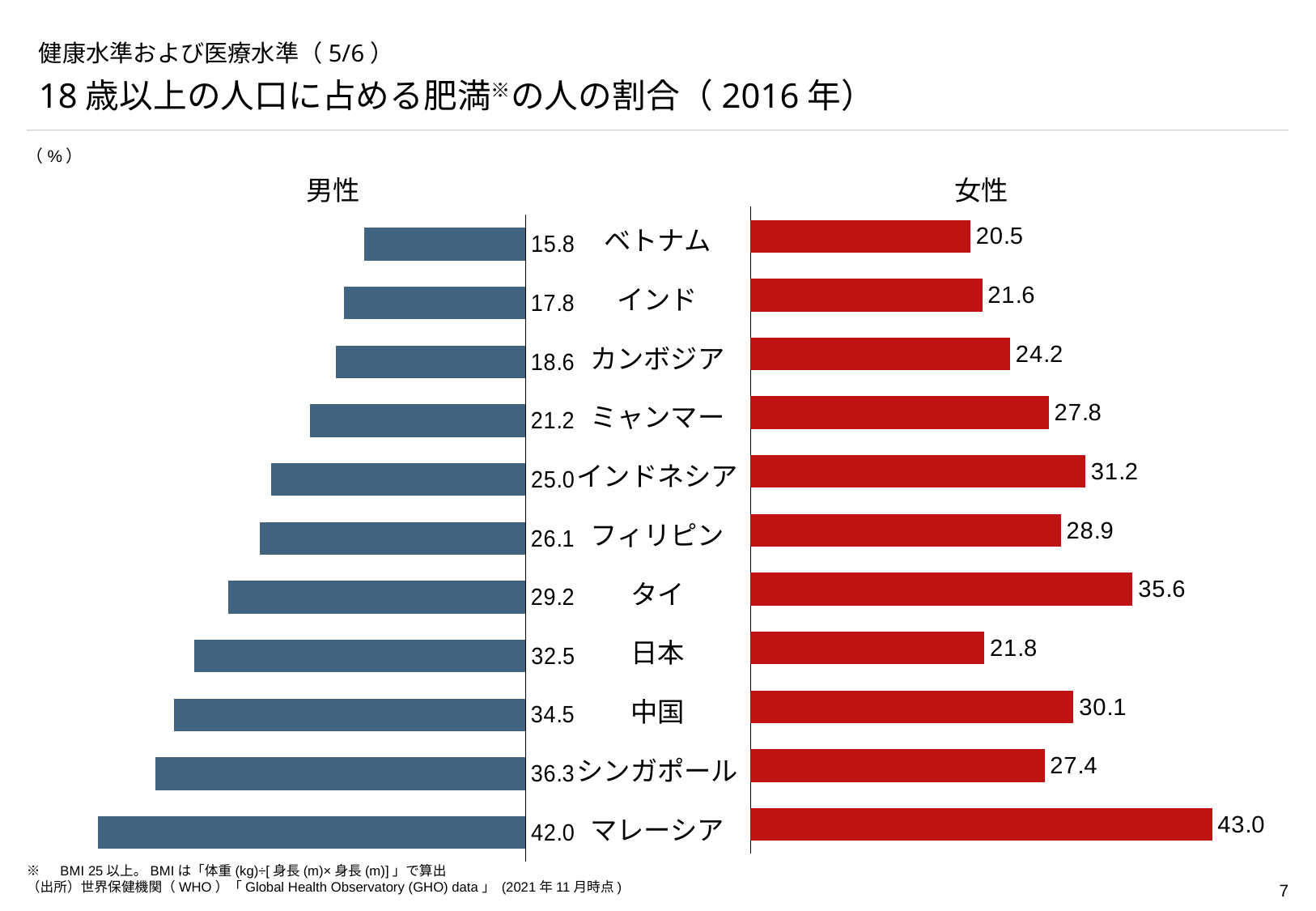
What is the male (男性) obesity rate for 日本? 32.5 Which country has the highest female (女性) obesity rate? マレーシア Which is larger, the male (男性) rate for 中国 or the female (女性) rate for 中国? 男性 (34.5) What is the female (女性) obesity rate for タイ? 35.6 Which is larger, the female (女性) rate for インドネシア or the female (女性) rate for フィリピン? インドネシア (31.2) Which country has the lowest male (男性) obesity rate? ベトナム Which country has the lowest female (女性) obesity rate? ベトナム How many countries are shown in the chart? 11 What colour are the bars for 女性 (female)? Red What is the difference between the male (男性) obesity rates of マレーシア and シンガポール? 5.7 What is the difference between the female (女性) and male (男性) obesity rates for 日本? 10.7 What kind of chart is shown on the slide? Bar chart